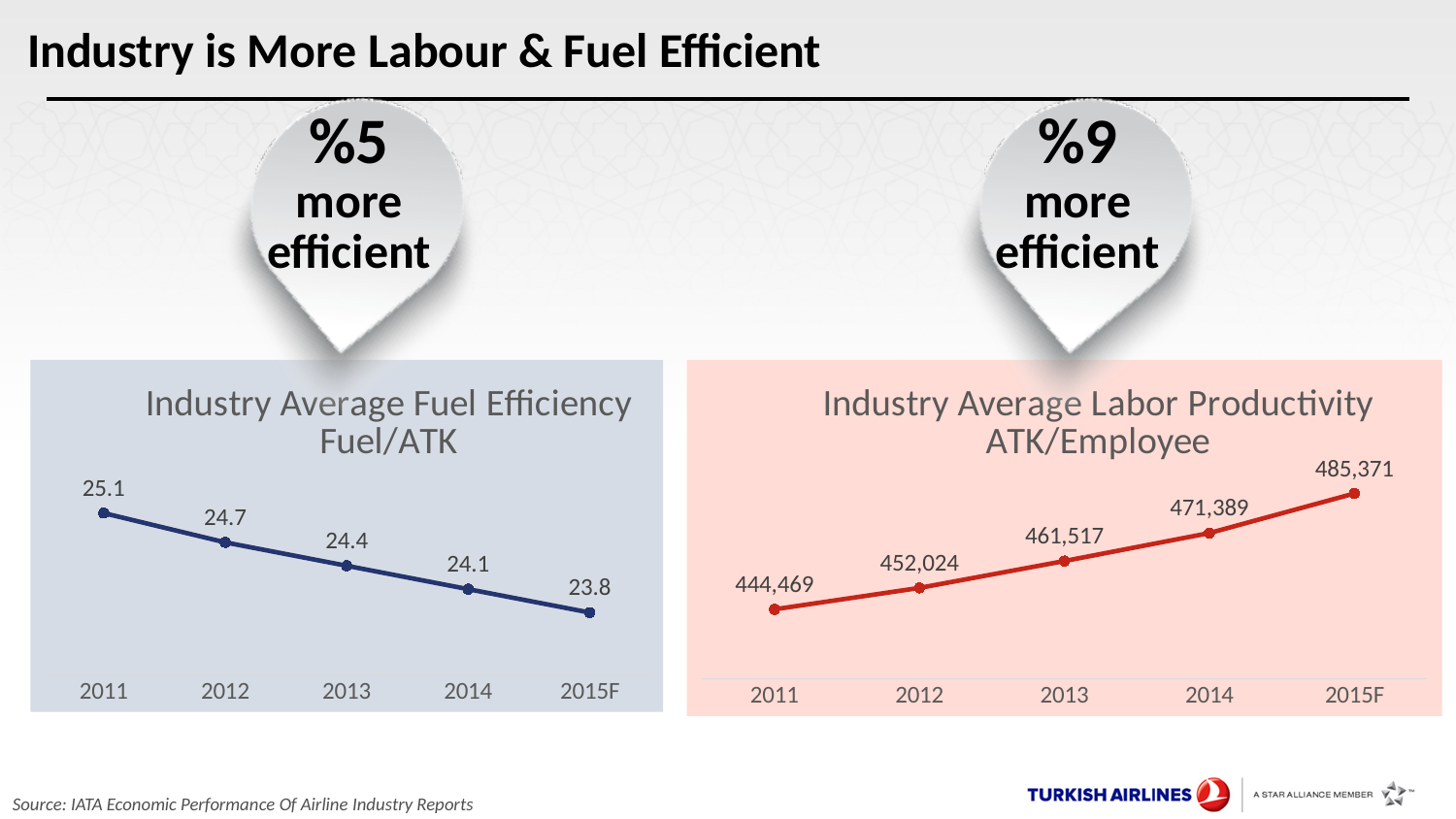
In the 'Industry Average Labor Productivity ATK/Employee' chart, what is the value for 2014? 471,389 In the 'Industry Average Labor Productivity ATK/Employee' chart, do the values rise or fall from 2011 to 2015F? Rise In the 'Industry Average Fuel Efficiency Fuel/ATK' chart, do the values rise or fall from 2011 to 2015F? Fall In the 'Industry Average Fuel Efficiency Fuel/ATK' chart, which year has the highest value? 2011 In the 'Industry Average Fuel Efficiency Fuel/ATK' chart, what is the difference between the 2011 and 2015F values? 1.3 What colour is the line in the 'Industry Average Labor Productivity ATK/Employee' chart? Red In the 'Industry Average Labor Productivity ATK/Employee' chart, which is larger, the value for 2012 or the value for 2013? 2013 In the 'Industry Average Labor Productivity ATK/Employee' chart, which year has the lowest value? 2011 What kind of chart is the 'Industry Average Labor Productivity ATK/Employee' chart? Line chart In the 'Industry Average Fuel Efficiency Fuel/ATK' chart, what is the value for 2013? 24.4 How many data points are plotted in the 'Industry Average Fuel Efficiency Fuel/ATK' chart? 5 In the 'Industry Average Labor Productivity ATK/Employee' chart, what is the difference between the 2015F and 2011 values? 40,902